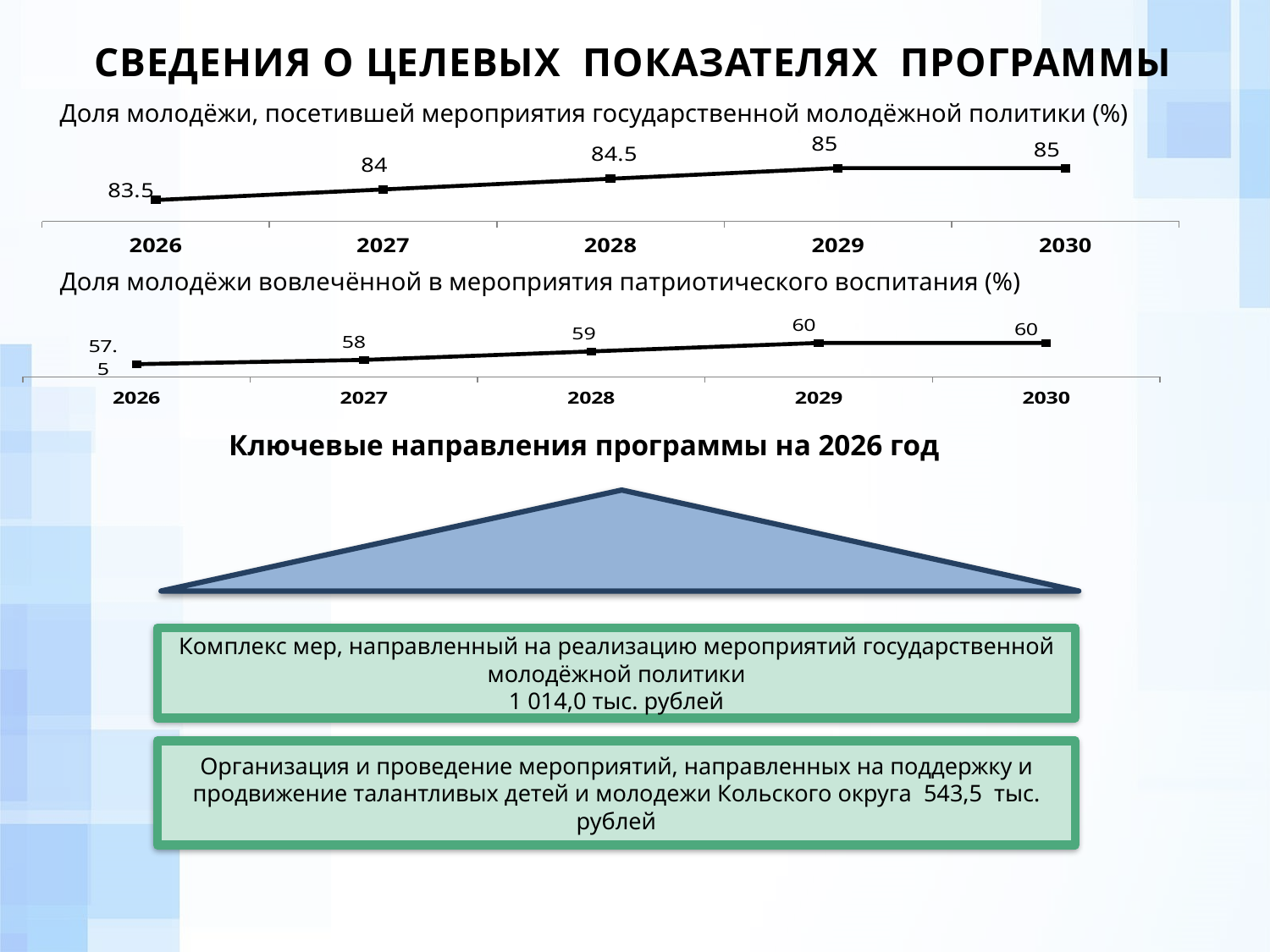
How many years are plotted in the top chart (Доля молодёжи, посетившей мероприятия государственной молодёжной политики)? 5 In the bottom chart (Доля молодёжи вовлечённой в мероприятия патриотического воспитания), which is larger: the value for 2027 or the value for 2028? 2028 In the top chart (Доля молодёжи, посетившей мероприятия государственной молодёжной политики), what is the value for 2028? 84.5 In the top chart (Доля молодёжи, посетившей мероприятия государственной молодёжной политики), do the values rise or fall from 2026 to 2029? rise In the bottom chart (Доля молодёжи вовлечённой в мероприятия патриотического воспитания), which year has the lowest value? 2026 What kind of chart is the bottom chart (Доля молодёжи вовлечённой в мероприятия патриотического воспитания)? line chart In the bottom chart (Доля молодёжи вовлечённой в мероприятия патриотического воспитания), what is the difference between the 2028 value and the 2026 value? 1.5 In the bottom chart (Доля молодёжи вовлечённой в мероприятия патриотического воспитания), what is the value for 2027? 58 In the top chart (Доля молодёжи, посетившей мероприятия государственной молодёжной политики), which year has the lowest value? 2026 In the bottom chart (Доля молодёжи вовлечённой в мероприятия патриотического воспитания), what is the value for 2029? 60 In the top chart (Доля молодёжи, посетившей мероприятия государственной молодёжной политики), what is the value for 2026? 83.5 In the top chart (Доля молодёжи, посетившей мероприятия государственной молодёжной политики), what is the difference between the 2030 value and the 2026 value? 1.5